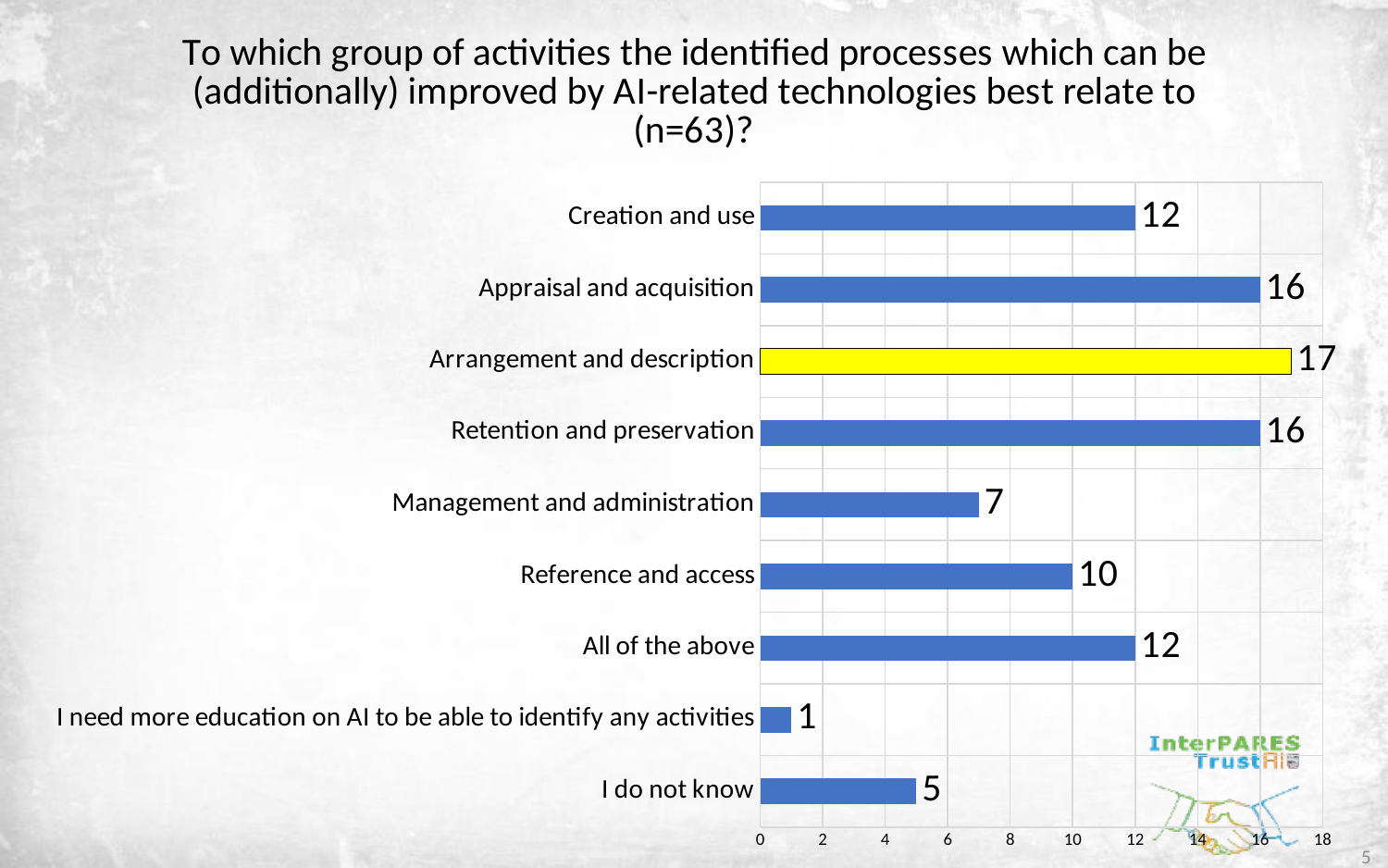
What is the value for Management and administration? 7 Is the value for Retention and preservation greater or less than 14? greater What kind of chart is shown on the slide? Bar chart What is the value for All of the above? 12 Which category has the lowest value? I need more education on AI to be able to identify any activities Which is larger, the value for Creation and use or the value for Management and administration? Creation and use Which category has the highest value? Arrangement and description What is the difference between the values for Appraisal and acquisition and Reference and access? 6 What is the value for Arrangement and description? 17 How many categories are shown in the chart? 9 What is the value for I do not know? 5 Which bar is highlighted in yellow? Arrangement and description